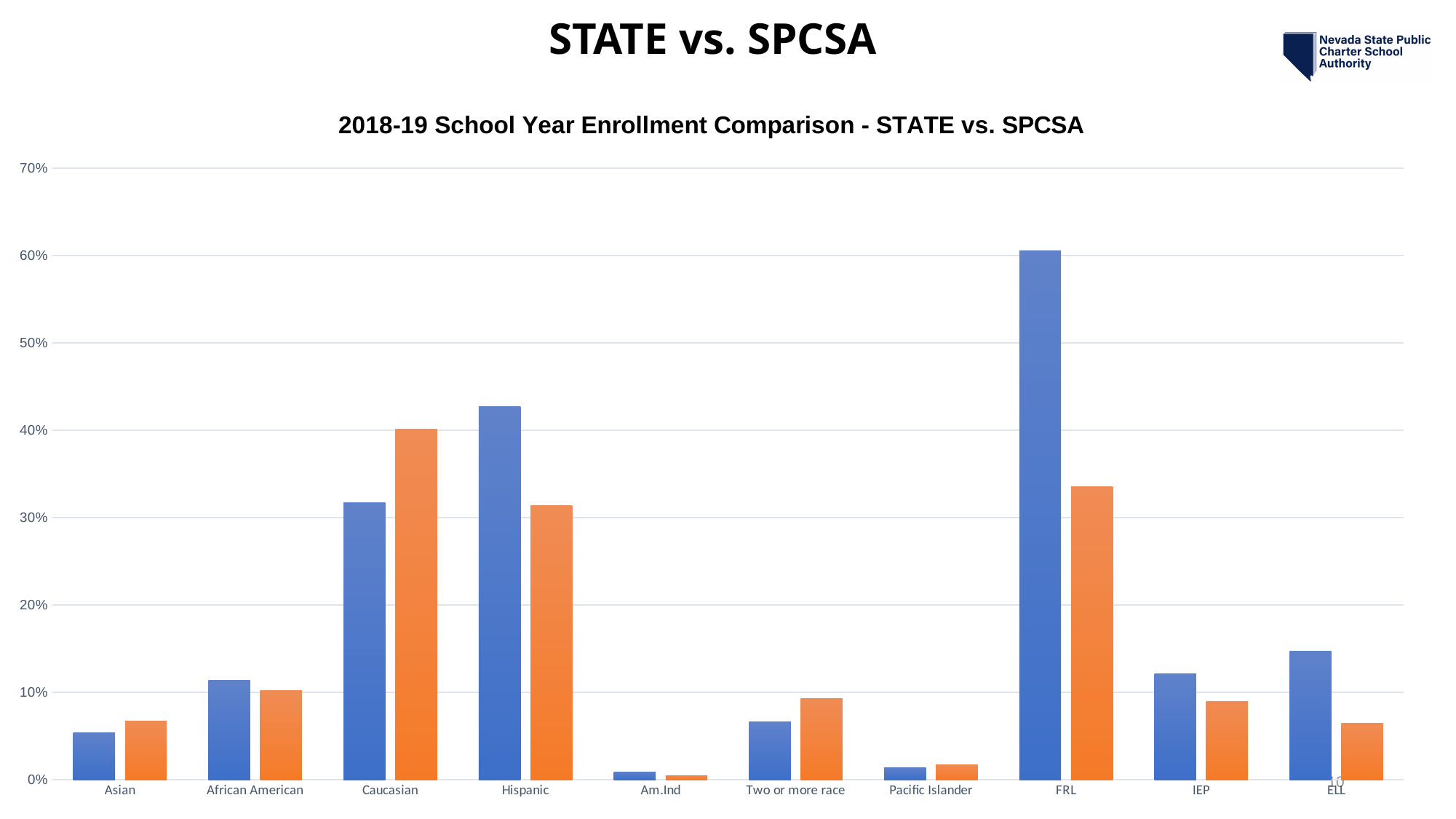
How many data series (bar colours) are plotted for each category? 2 What kind of chart is shown on the slide? bar chart Which category has the shortest orange bar? Am.Ind For Caucasian, which bar is taller, the blue bar or the orange bar? orange Is the blue bar for Hispanic greater or less than 40%? greater How many categories are shown on the x axis of the chart? 10 Is the orange bar for ELL greater or less than 10%? less Which category has the tallest blue bar? FRL For Hispanic, which bar is taller, the blue bar or the orange bar? blue Is the blue bar for IEP greater or less than 10%? greater What is the title of the chart? 2018-19 School Year Enrollment Comparison - STATE vs. SPCSA